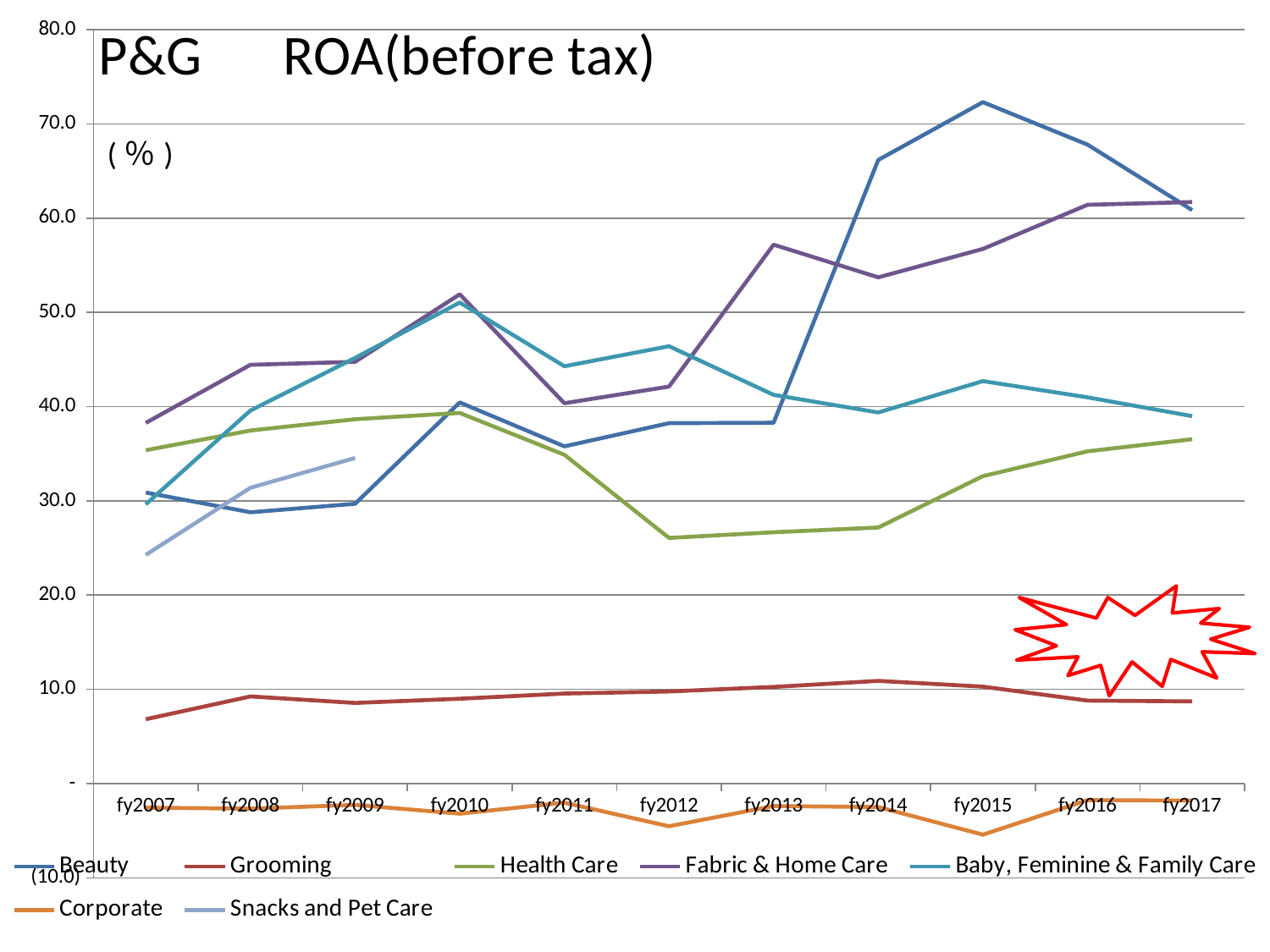
How many series does the legend list? 7 What kind of chart is shown on the slide? line chart In fy2014, which is larger: Beauty or Health Care? Beauty Is the value for Fabric & Home Care in fy2013 greater or less than 50.0? greater Is the value for Beauty in fy2015 greater or less than 70.0? greater Is the value for Corporate in fy2015 greater or less than 0? less How many fiscal years are shown on the x axis? 11 In which fiscal year does the Beauty series reach its highest value? fy2015 Does the Beauty series rise or fall from fy2015 to fy2017? fall What is the title of the chart? P&G ROA(before tax) Which series has the lowest values across the chart? Corporate